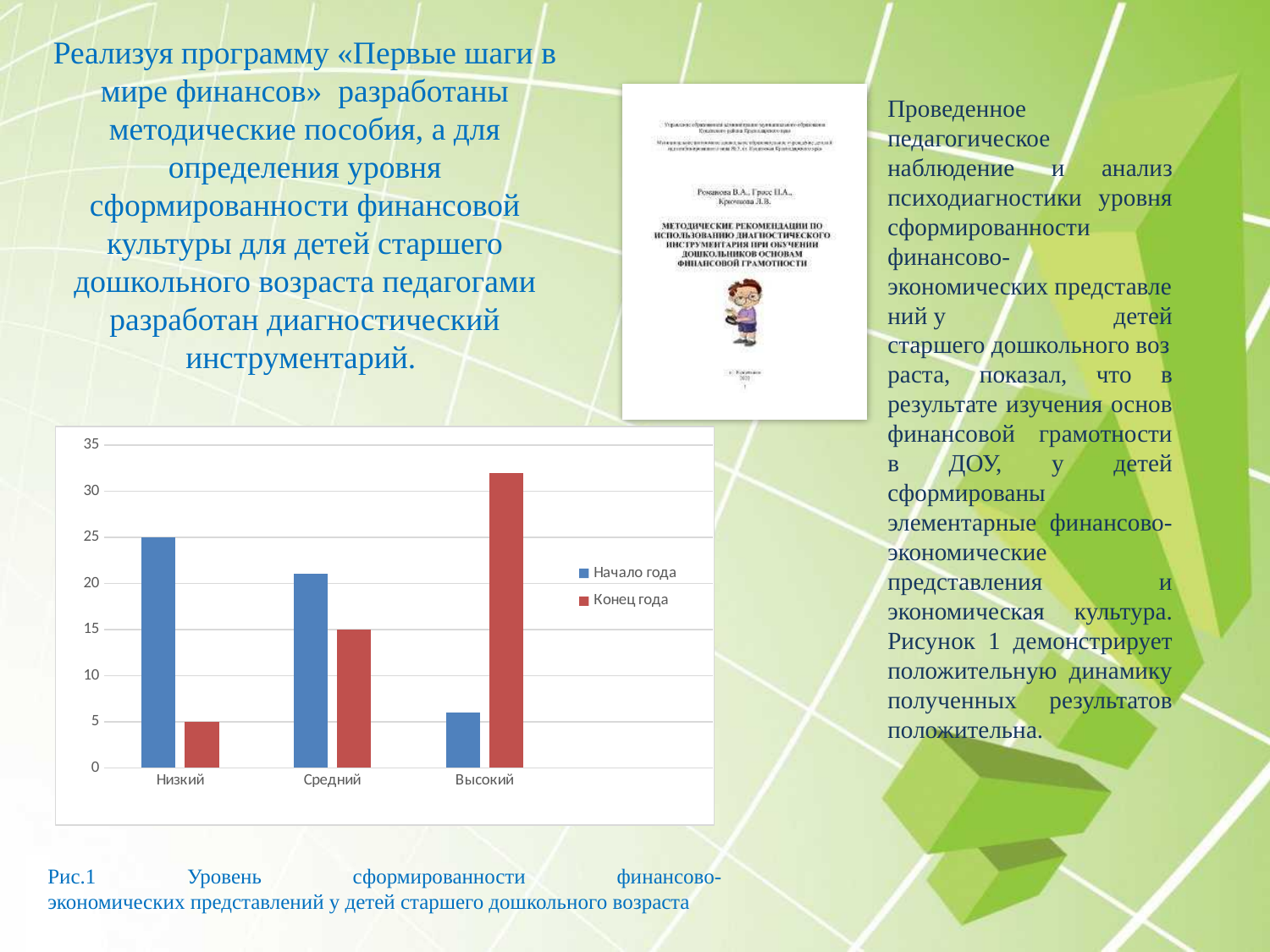
How many series does the chart legend list? 2 Which category has the highest value in the Конец года series? Высокий For the Низкий category, which series has the larger value, Начало года or Конец года? Начало года What is the value for Низкий in the Начало года series? 25 What is the difference between the Начало года and Конец года values for Низкий? 20 What kind of chart is shown on the slide? bar chart How many categories are shown on the x axis of the chart? 3 Is the value for Высокий in the Конец года series greater or less than 30? greater What is the value for Низкий in the Конец года series? 5 Is the value for Высокий in the Начало года series greater or less than 10? less Which category has the highest value in the Начало года series? Низкий What is the value for Средний in the Конец года series? 15